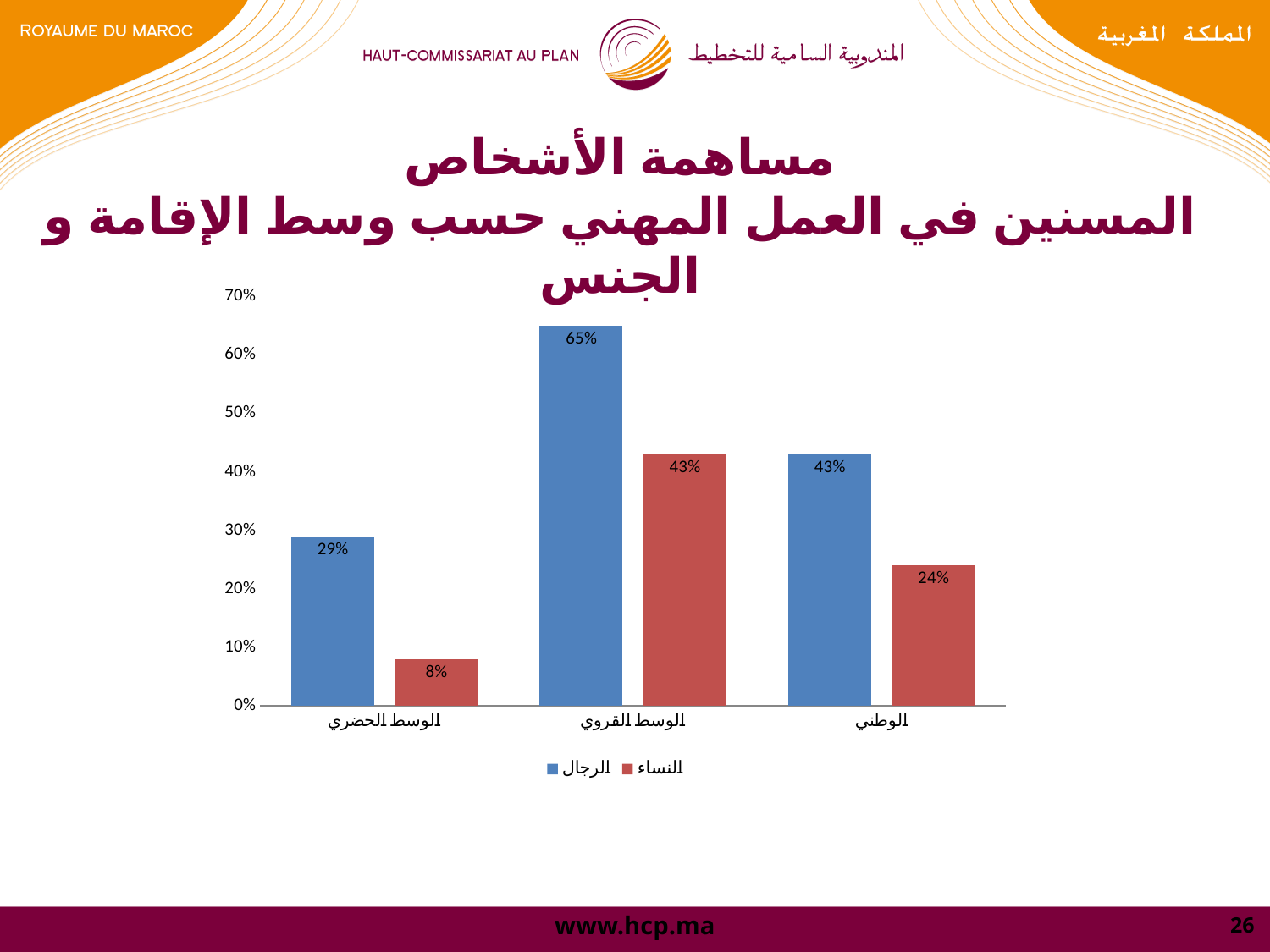
What is the value for الرجال in الوسط الحضري? 29% Which category has the lowest value for النساء? الوسط الحضري What is the value for النساء in الوطني? 24% Which is larger: the value for الرجال in الوطني or the value for النساء in الوسط القروي? They are equal (43%) How many categories are shown on the x axis of the chart? 3 What is the value for النساء in الوسط الحضري? 8% Which category has the highest value for الرجال? الوسط القروي Which colour represents the النساء series in the chart? red What is the value for الرجال in الوسط القروي? 65% How many series does the chart legend list? 2 What type of chart is shown on the slide? bar chart What is the difference between the الرجال and النساء values in الوسط القروي? 22%